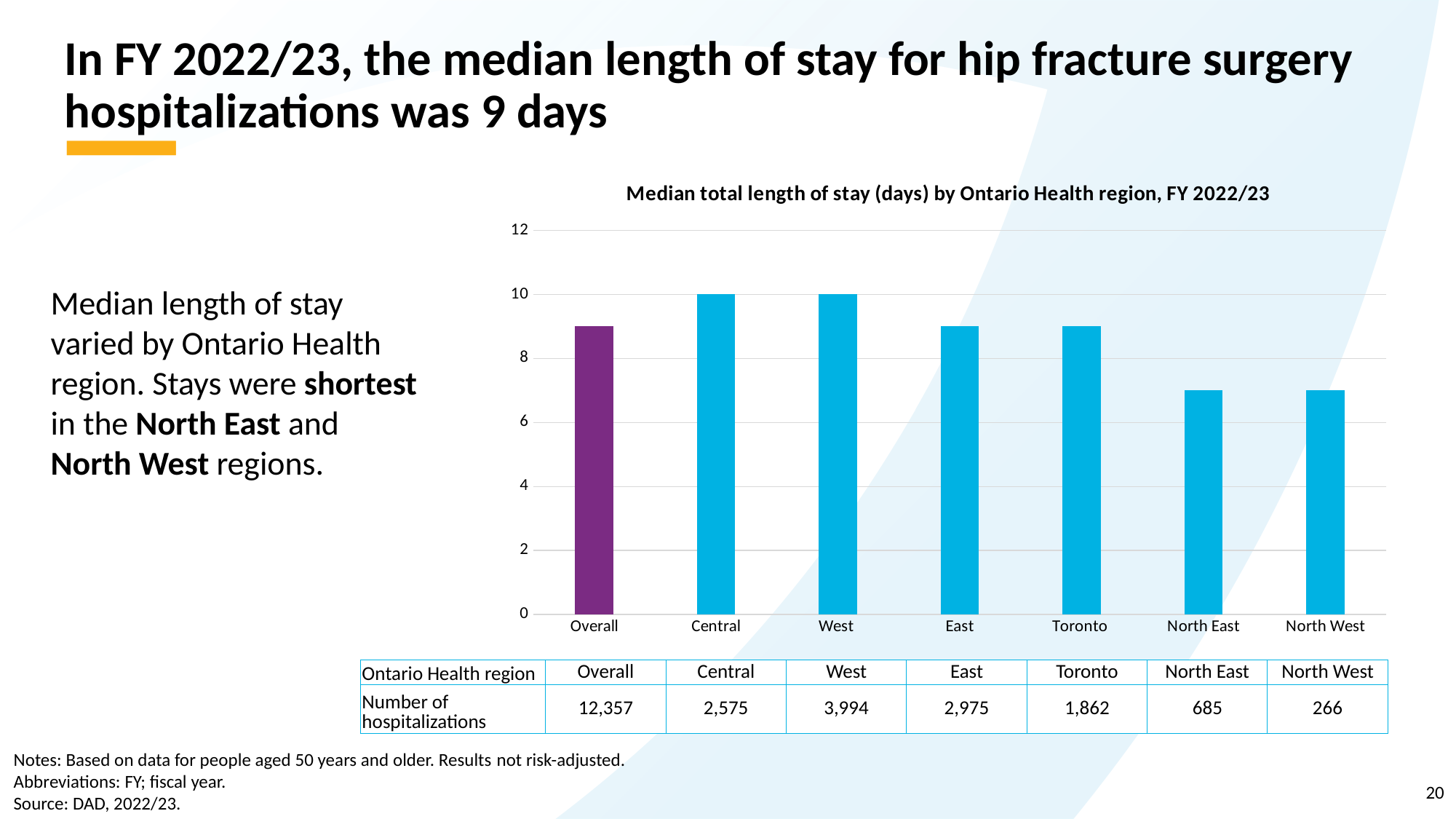
Is the value for North West greater or less than 6? greater What is the median total length of stay for the Central region? 10 Which has a higher median total length of stay, Central or East? Central How many bars (categories) are shown in the chart? 7 Which two regions have the lowest median total length of stay? North East and North West Which bar is shown in a different colour (purple) from the others? Overall What is the median total length of stay for Overall? 9 Is the value for North East greater or less than 8? less Is the value for East greater or less than 8? greater What is the median total length of stay for the West region? 10 What is the title of the chart? Median total length of stay (days) by Ontario Health region, FY 2022/23 What type of chart is shown on the slide? bar chart